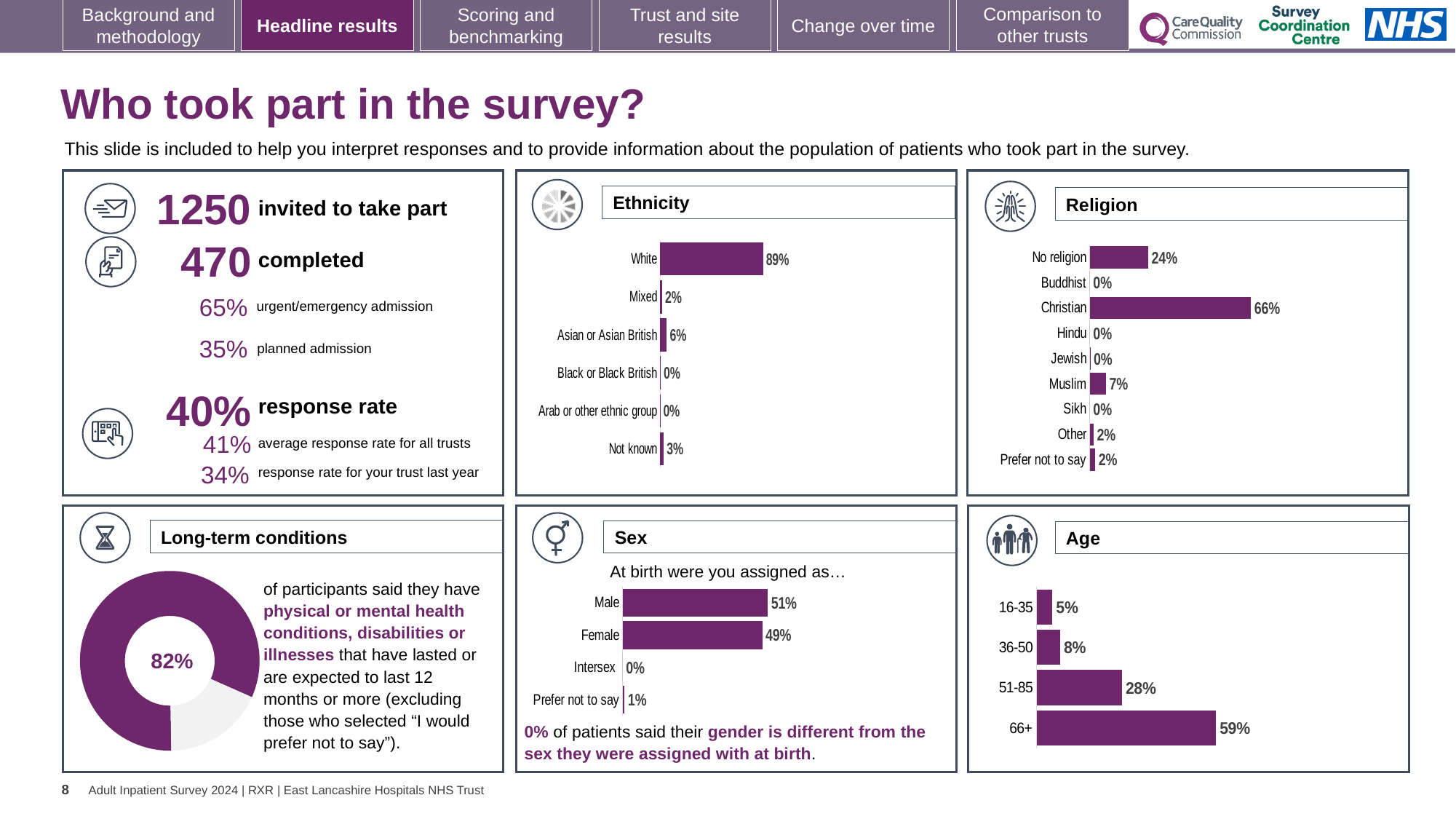
In the Ethnicity chart, what is the value for Asian or Asian British? 6% In the Religion chart, which category has the highest value? Christian How many categories does the Religion chart show? 9 In the Religion chart, what is the value for Muslim? 7% In the Age chart, do the values rise or fall from 16-35 to 66+? Rise How many categories does the Ethnicity chart show? 6 In the Long-term conditions chart, what share of participants said they have physical or mental health conditions, disabilities or illnesses? 82% In the Ethnicity chart, what percentage of respondents were White? 89% What kind of chart is the Long-term conditions chart? Doughnut chart In the Age chart, which age group has the lowest value? 16-35 In the Age chart, what is the difference between the 66+ and 51-85 values? 31% In the Sex chart, which is larger, Male or Female? Male